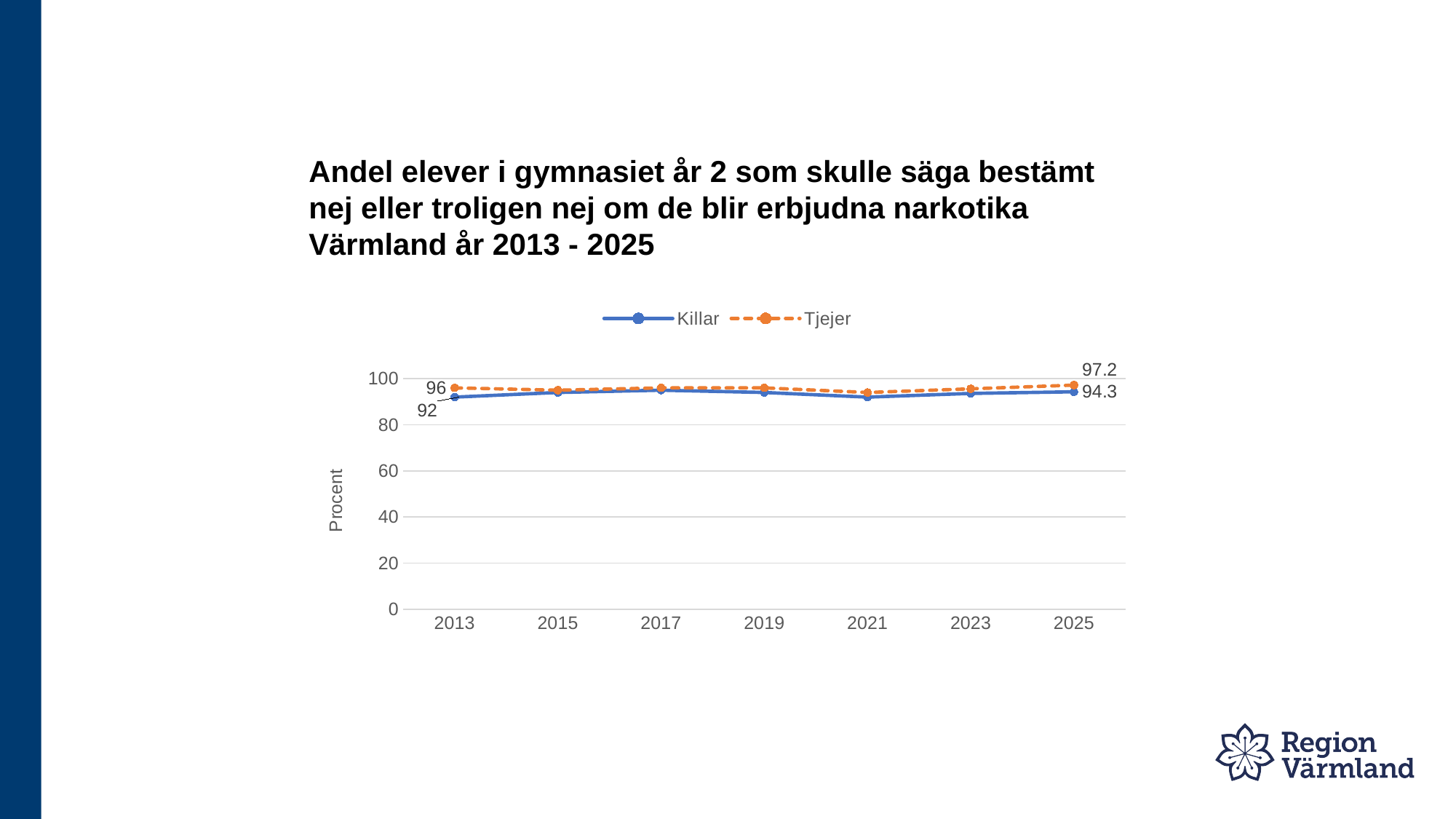
What is the value for Tjejer in 2025? 97.2 What is the difference between the Tjejer and Killar values in 2025? 2.9 What kind of chart is shown on the slide? line chart How many series does the legend list? 2 What is the value for Tjejer in 2013? 96 What is the value for Killar in 2025? 94.3 What is the value for Killar in 2013? 92 What is the label on the y axis? Procent By how much did the Killar value change from 2013 to 2025? 2.3 How many years are shown on the x axis? 7 In 2013, which series has the higher value, Killar or Tjejer? Tjejer Is the value for Killar in 2021 greater or less than 80? greater